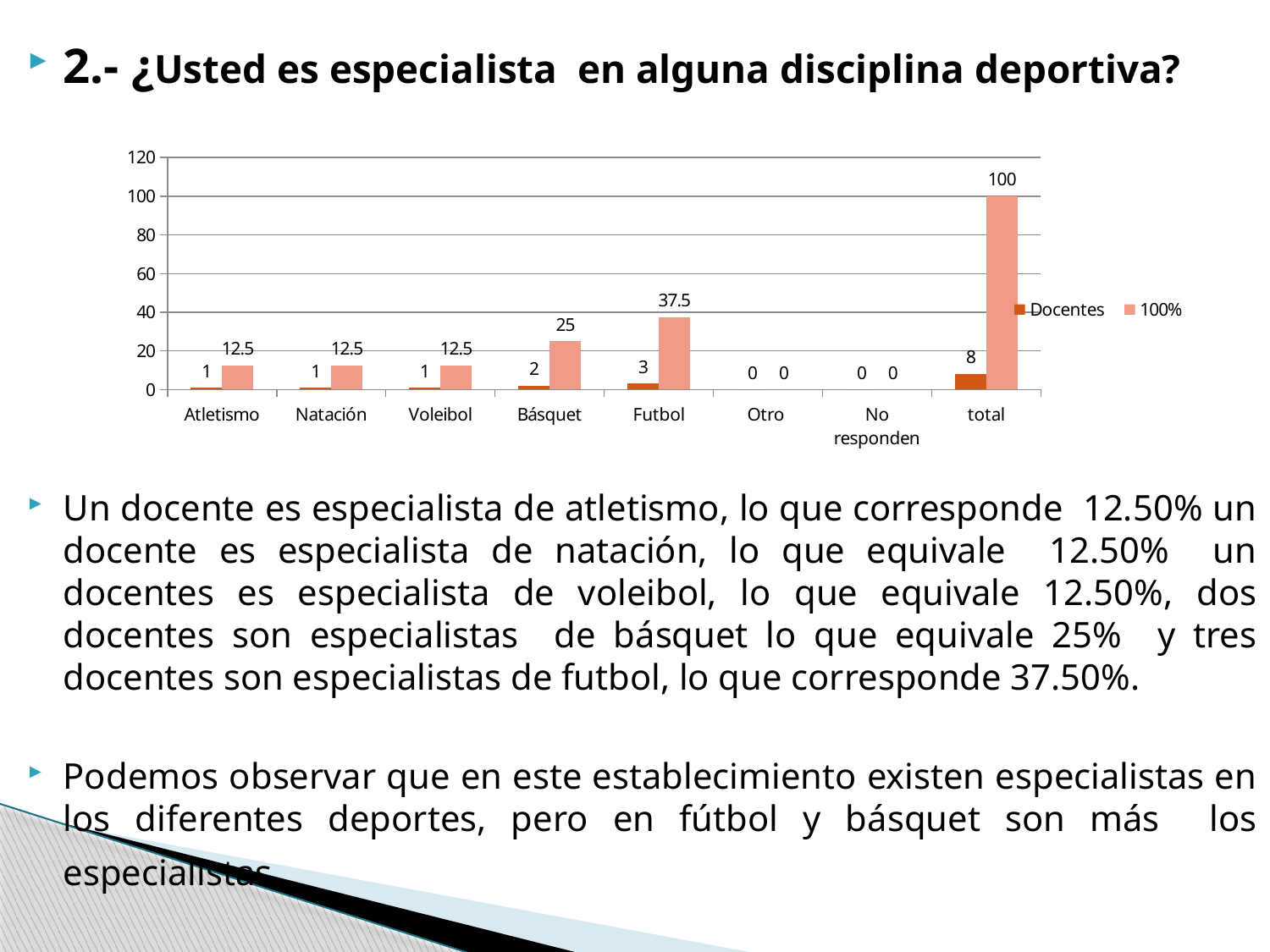
Which is larger, the Docentes value for Básquet or for Natación? Básquet What is the 100% value for Otro? 0 How many series does the legend list? 2 What is the difference between the 100% values for Futbol and Básquet? 12.5 What is the 100% value for Futbol? 37.5 Excluding total, which category has the highest 100% value? Futbol What is the Docentes value for Futbol? 3 What is the 100% value for Básquet? 25 What are the two legend entries? Docentes and 100% What kind of chart is shown? bar chart What is the Docentes value for total? 8 How many categories are shown on the x axis? 8